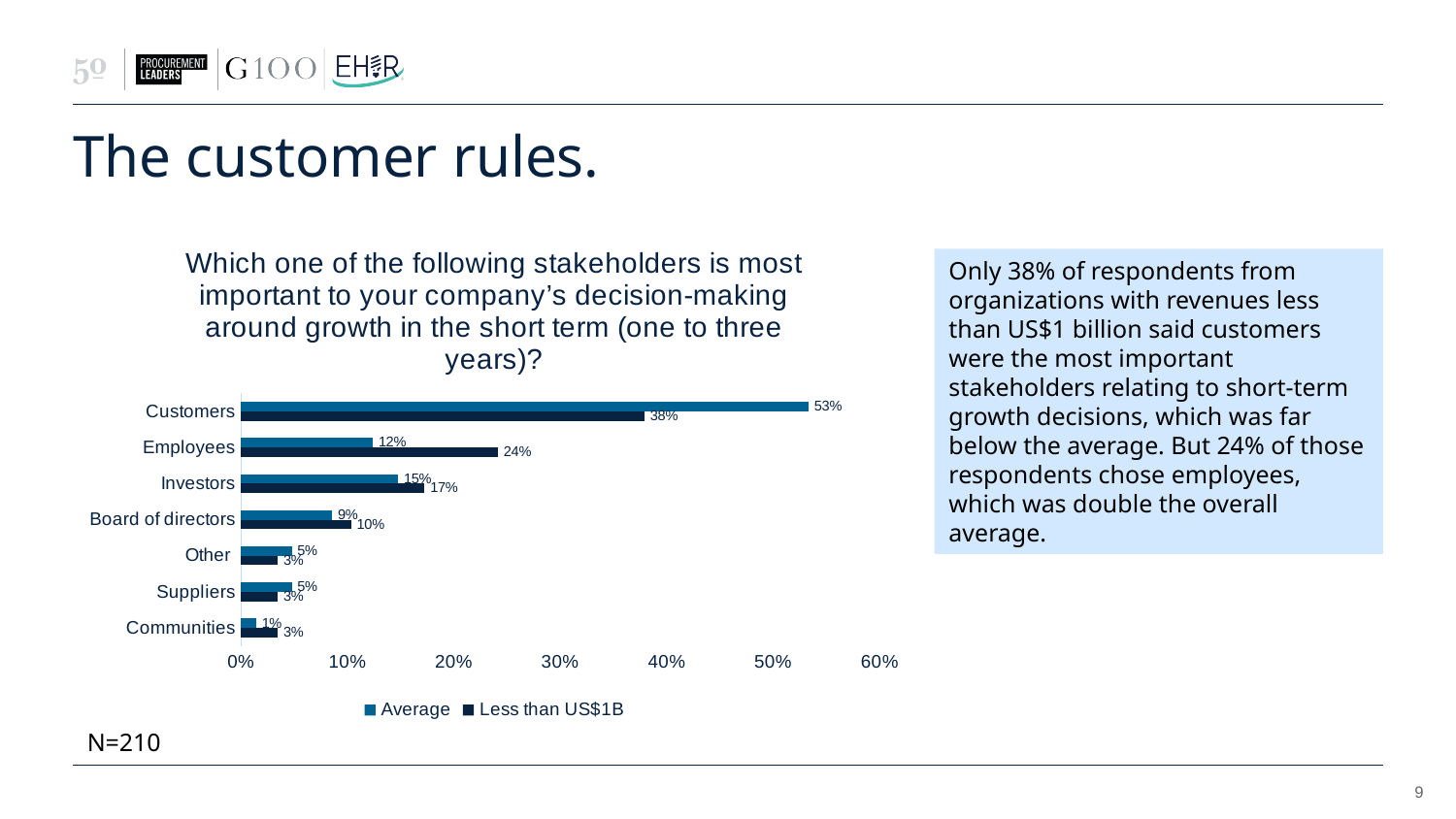
Which stakeholder has the highest Average value? Customers How many series does the legend list? 2 What is the Average value for Customers? 53% What is the Less than US$1B value for Communities? 3% How many stakeholder categories are shown on the chart? 7 What is the difference between the Average and Less than US$1B values for Customers? 15% What is the sample size (N) stated below the chart? N=210 Which stakeholder has the lowest Average value? Communities What is the Average value for Investors? 15% What kind of chart is shown on the slide? Bar chart For Employees, which series has the larger value: Average or Less than US$1B? Less than US$1B What is the Less than US$1B value for Employees? 24%